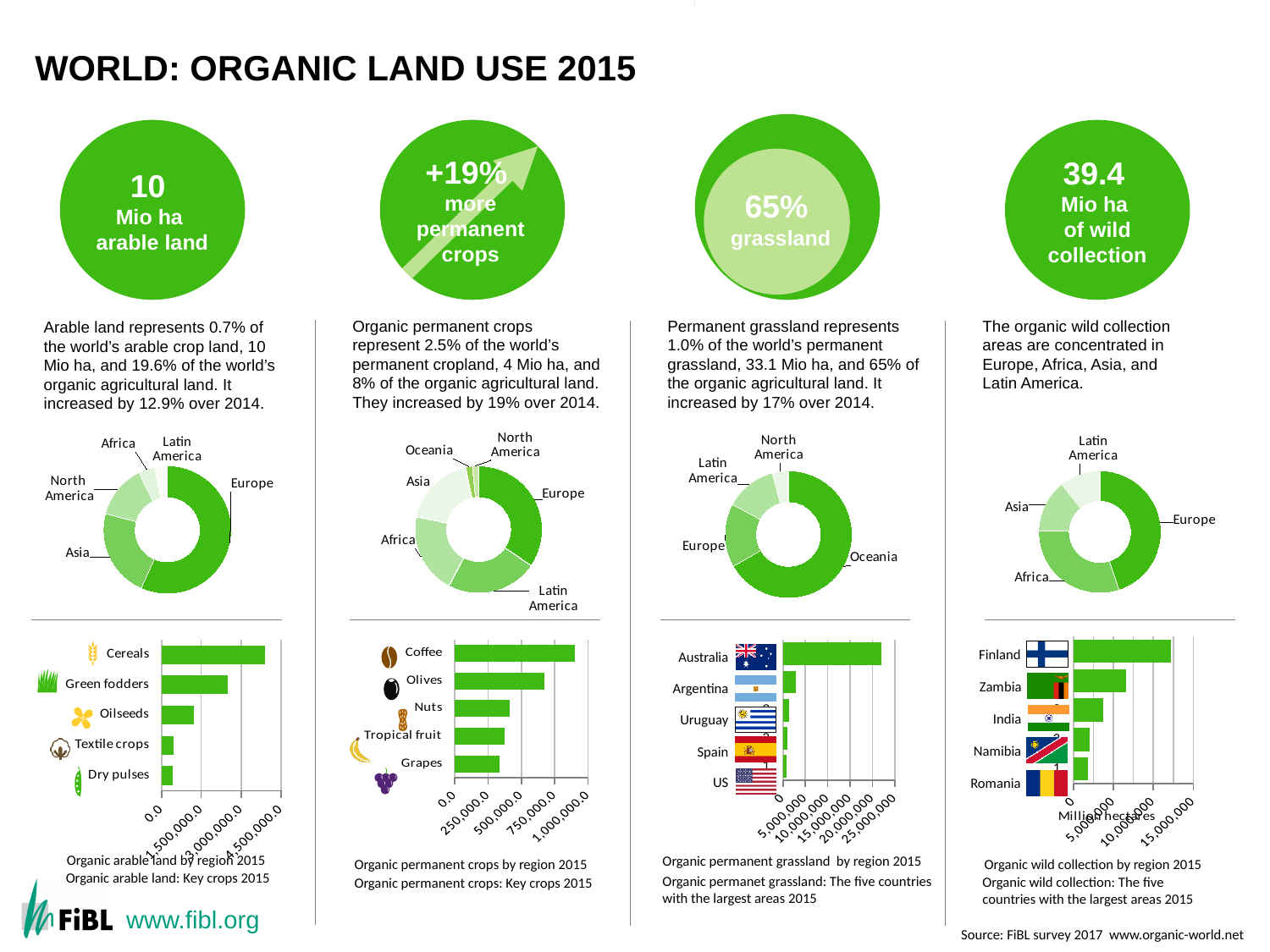
In the 'Organic wild collection: The five countries with the largest areas 2015' chart, which is larger, Zambia or India? Zambia In the 'Organic permanent crops: Key crops 2015' bar chart, which crop has the largest area? Coffee In the 'Organic permanent grassland: The five countries with the largest areas 2015' chart, is the value for Australia greater or less than 20,000,000? greater In the 'Organic permanent grassland: The five countries with the largest areas 2015' chart, which country has the largest area? Australia How many regions are shown in the 'Organic wild collection by region 2015' donut chart? 4 In the 'Organic permanent crops: Key crops 2015' bar chart, is the value for Olives greater or less than 500,000.0? greater What type of chart is 'Organic permanent grassland by region 2015'? Donut chart In the 'Organic wild collection: The five countries with the largest areas 2015' chart, which country has the largest area? Finland In the 'Organic arable land: Key crops 2015' bar chart, is the value for Cereals greater or less than 1,000,000.0? greater In the 'Organic permanent crops: Key crops 2015' bar chart, which crop has the smallest area? Grapes How many crops are shown in the 'Organic arable land: Key crops 2015' bar chart? 5